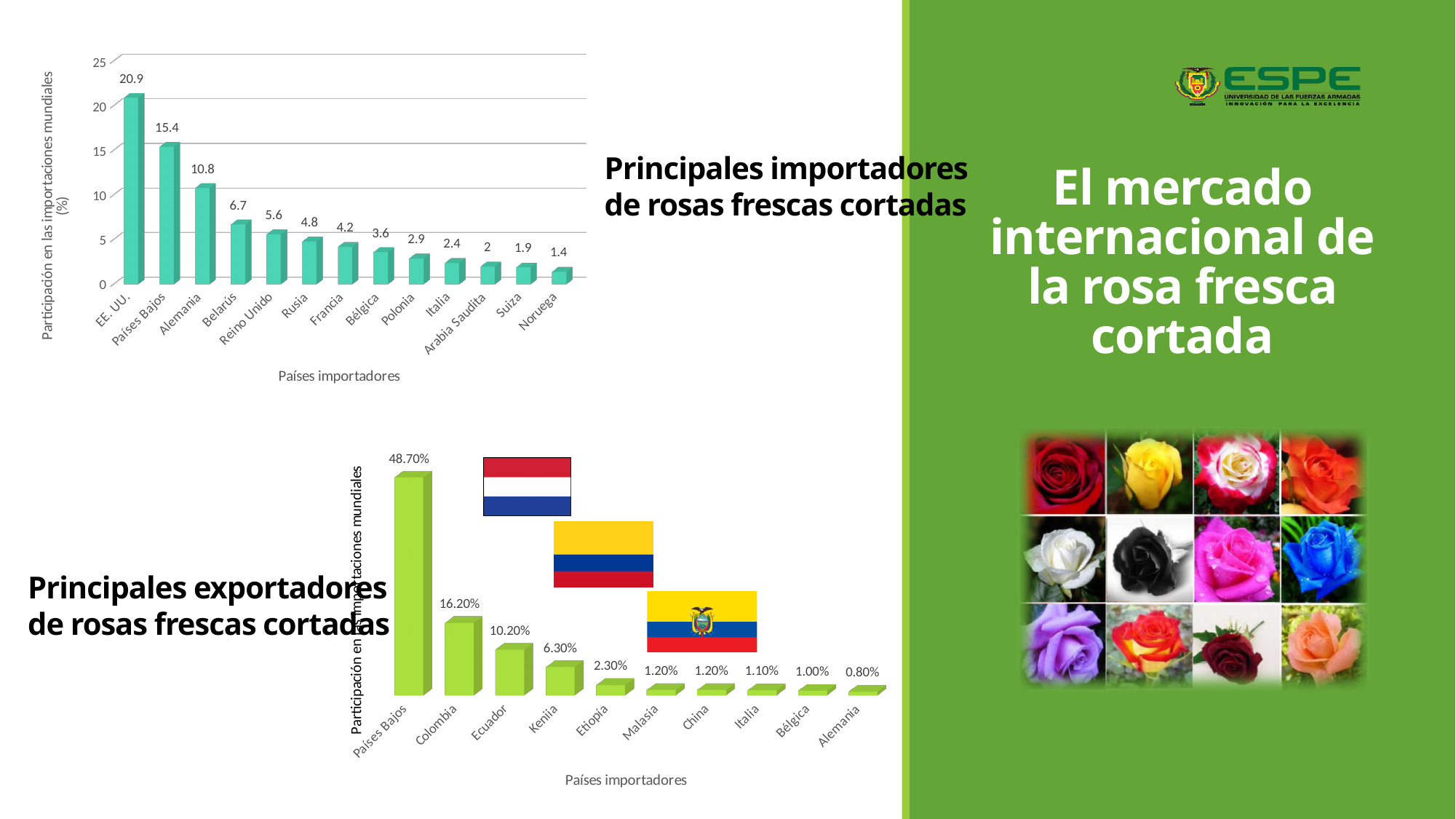
In the top chart (Principales importadores de rosas frescas cortadas), what is the value for Alemania? 10.8 In the bottom chart (Principales exportadores de rosas frescas cortadas), how many countries are shown? 10 In the bottom chart (Principales exportadores de rosas frescas cortadas), what is the value for Ecuador? 10.20% In the bottom chart (Principales exportadores de rosas frescas cortadas), which country has the lowest value? Alemania In the top chart (Principales importadores de rosas frescas cortadas), is the value for Belarús greater or less than 5? greater In the bottom chart (Principales exportadores de rosas frescas cortadas), which country has the highest value? Países Bajos In the bottom chart (Principales exportadores de rosas frescas cortadas), which is larger, the value for Colombia or the value for Kenia? Colombia In the top chart (Principales importadores de rosas frescas cortadas), what is the difference between the values for EE. UU. and Países Bajos? 5.5 In the top chart (Principales importadores de rosas frescas cortadas), which country has the highest value? EE. UU. In the top chart (Principales importadores de rosas frescas cortadas), which country has the lowest value? Noruega In the top chart (Principales importadores de rosas frescas cortadas), how many countries are shown? 13 What kind of chart is the bottom chart (Principales exportadores de rosas frescas cortadas)? Bar chart